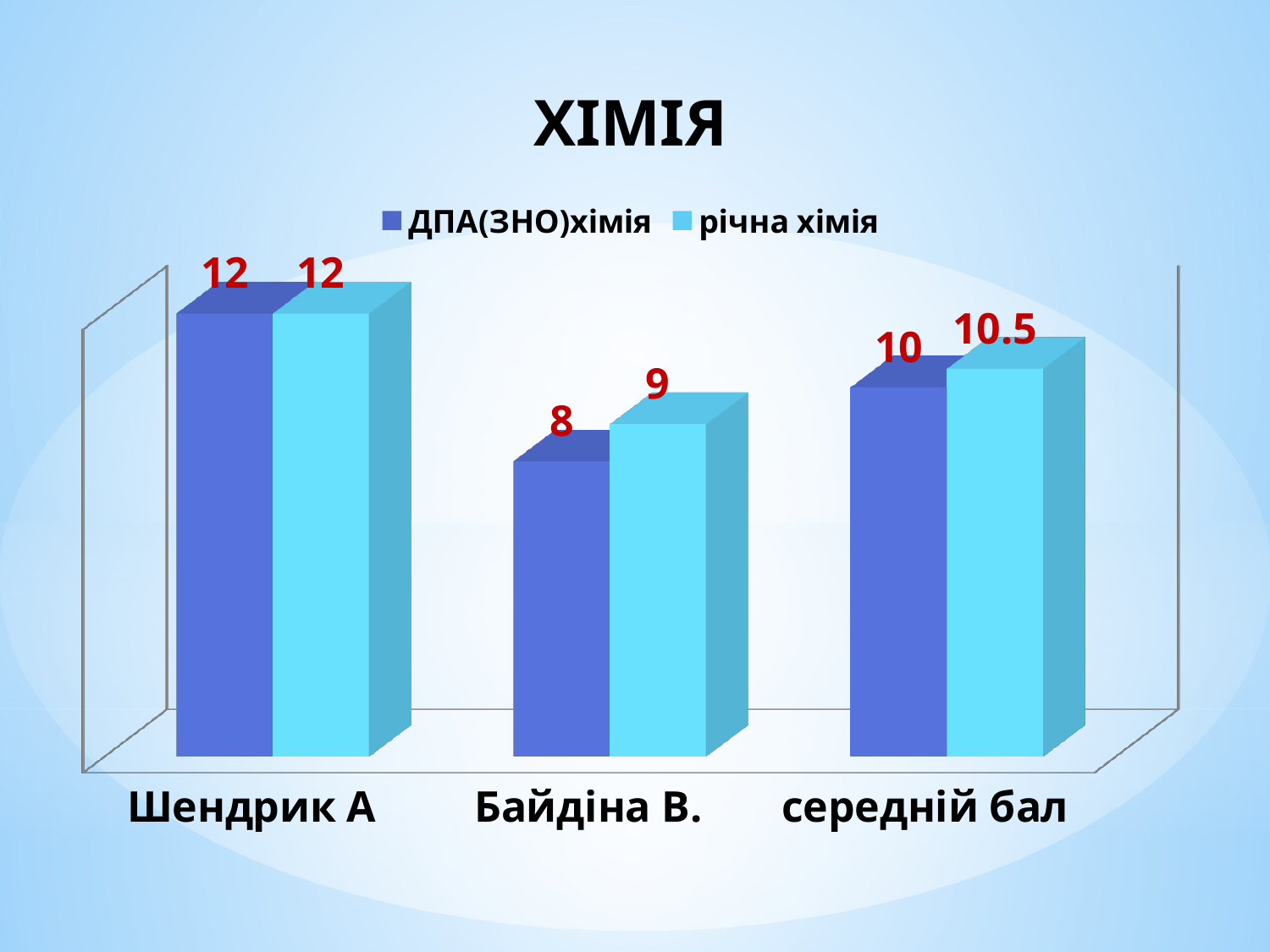
Which category has the lowest ДПА(ЗНО)хімія value? Байдіна В. What is the difference between the річна хімія and ДПА(ЗНО)хімія values for Байдіна В.? 1 What type of chart is shown on the slide? bar chart How many categories are shown on the x axis? 3 What is the ДПА(ЗНО)хімія value for Шендрик А? 12 What is the річна хімія value for середній бал? 10.5 What is the річна хімія value for Байдіна В.? 9 Which category has the highest річна хімія value? Шендрик А How many series does the legend list? 2 For Байдіна В., which is larger: the ДПА(ЗНО)хімія value or the річна хімія value? річна хімія What is the difference between the річна хімія and ДПА(ЗНО)хімія values for середній бал? 0.5 What is the ДПА(ЗНО)хімія value for Байдіна В.? 8